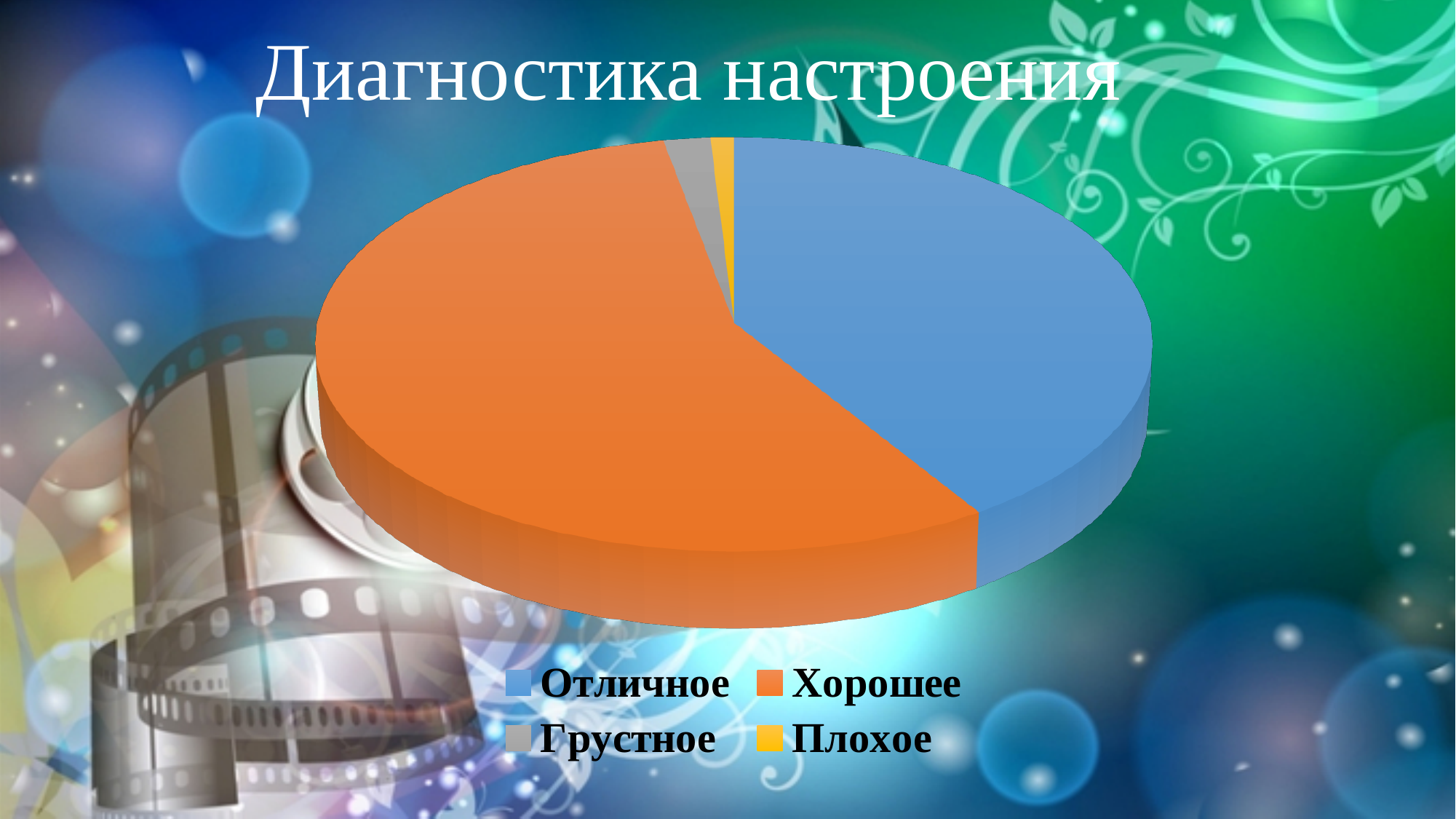
Which slice is larger, Грустное or Плохое? Грустное What is the title of the chart on the slide? Диагностика настроения Which category has the smallest slice of the pie? Плохое Which category is shown in orange in the pie chart? Хорошее How many categories (slices) does the pie chart have? 4 Which slice is larger, Отличное or Грустное? Отличное What kind of chart is shown on the slide? pie chart Which category is the second largest slice of the pie? Отличное Which category has the largest slice of the pie? Хорошее Which slice is larger, Хорошее or Отличное? Хорошее